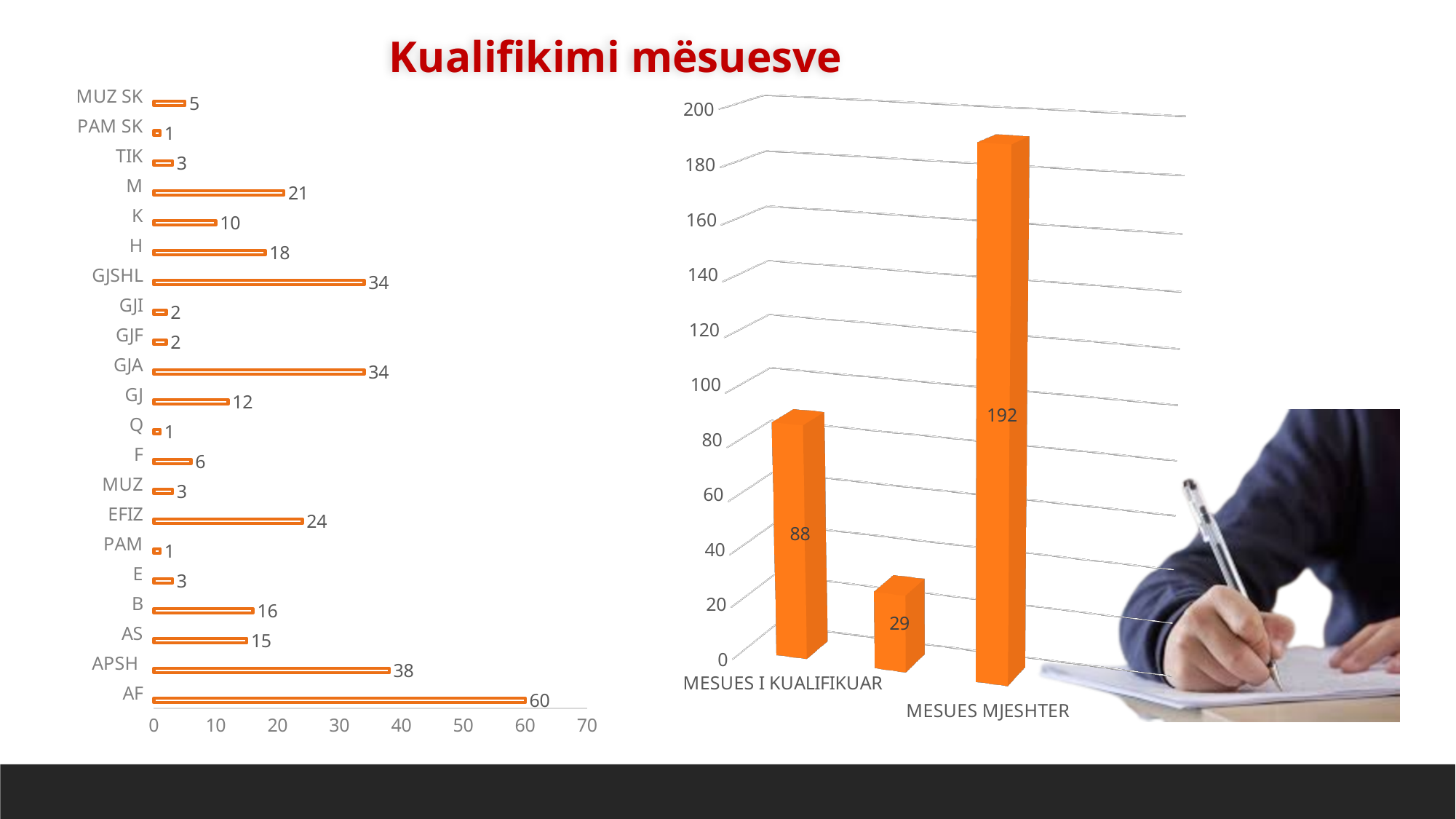
In the left bar chart, what is the value for APSH? 38 In the left bar chart, what is the value for EFIZ? 24 In the right chart, what is the difference between the values for MESUES I KUALIFIKUAR and MESUES MJESHTER? 104 In the left bar chart, what is the difference between the values for AF and APSH? 22 In the left bar chart, which is larger, the value for M or the value for H? M What is the title of the slide? Kualifikimi mësuesve In the left bar chart, how many categories are shown? 21 In the right chart, what is the value for MESUES I KUALIFIKUAR? 88 In the left bar chart, which category has the highest value? AF In the right chart, what is the value for MESUES MJESHTER? 192 In the left bar chart, what is the value for AF? 60 What kind of chart is the chart on the left of the slide? Bar chart